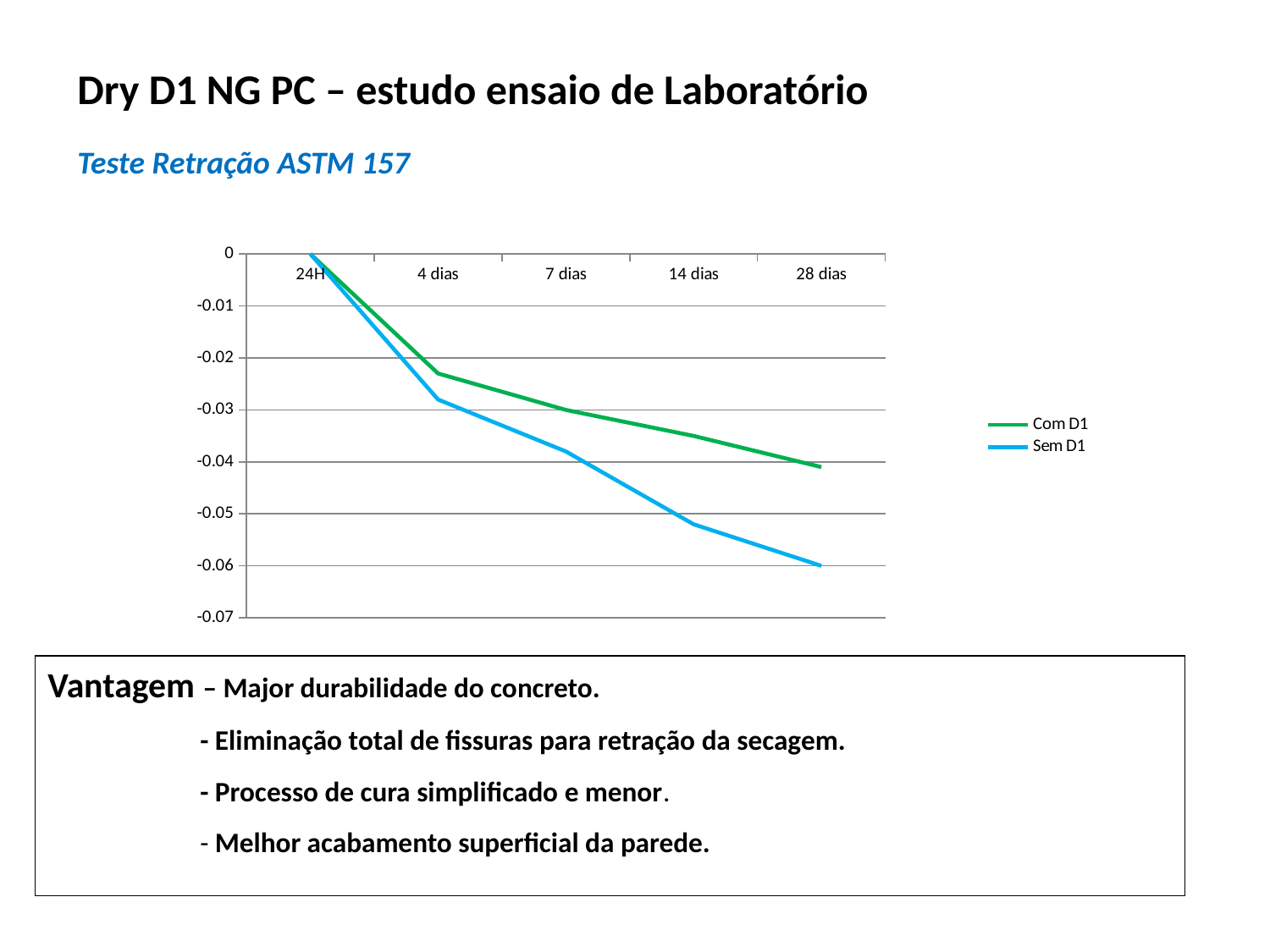
At 28 dias, which series has the higher (less negative) value, Com D1 or Sem D1? Com D1 Is the value for Sem D1 at 14 dias greater or less than -0.05? less How many series does the legend list? 2 What is the value of the Sem D1 series at 28 dias? -0.06 What are the two series named in the legend? Com D1 and Sem D1 How many time points are plotted along the x axis? 5 What is the value of the Com D1 series at 24H? 0 At 14 dias, which series has the lower value, Com D1 or Sem D1? Sem D1 Is the value for Com D1 at 14 dias greater or less than -0.04? greater Do the values of the Sem D1 series rise or fall from 24H to 28 dias? fall What kind of chart is shown on the slide? line chart Which series is drawn in green? Com D1